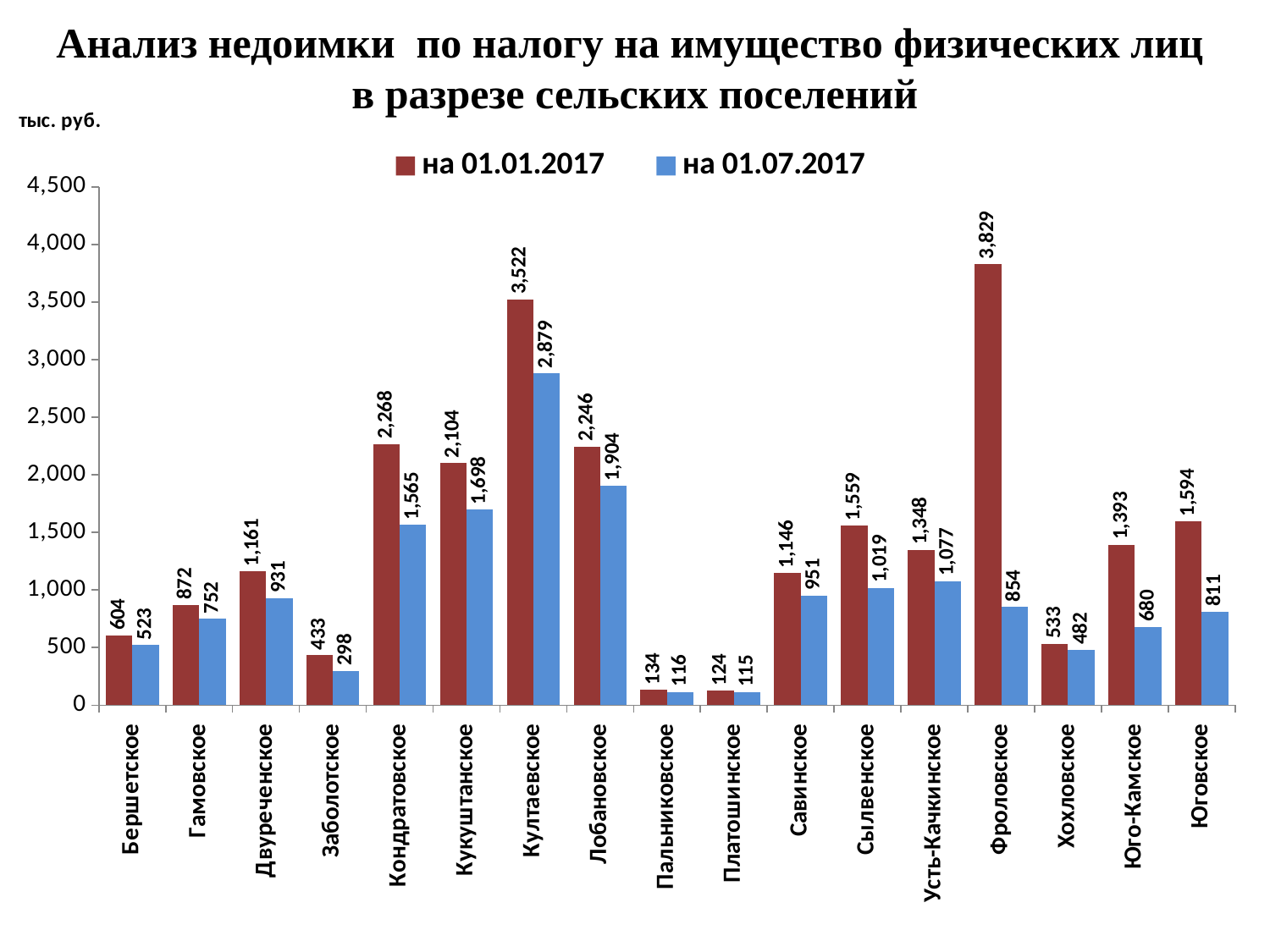
What unit is indicated in the top-left corner of the chart? тыс. руб. What is the value for Култаевское in the series 'на 01.01.2017'? 3,522 Which settlement has the highest value in the series 'на 01.01.2017'? Фроловское What is the value for Заболотское in the series 'на 01.07.2017'? 298 Which settlement has the highest value in the series 'на 01.07.2017'? Култаевское What kind of chart is shown on the slide? Bar chart How many settlements are shown on the x axis? 17 What is the value for Фроловское in the series 'на 01.07.2017'? 854 Which settlement has the lowest value in the series 'на 01.01.2017'? Платошинское What is the difference between the 'на 01.01.2017' and 'на 01.07.2017' values for Фроловское? 2,975 How many series does the legend list? 2 Which is larger: the 'на 01.01.2017' value for Кондратовское or for Лобановское? Кондратовское